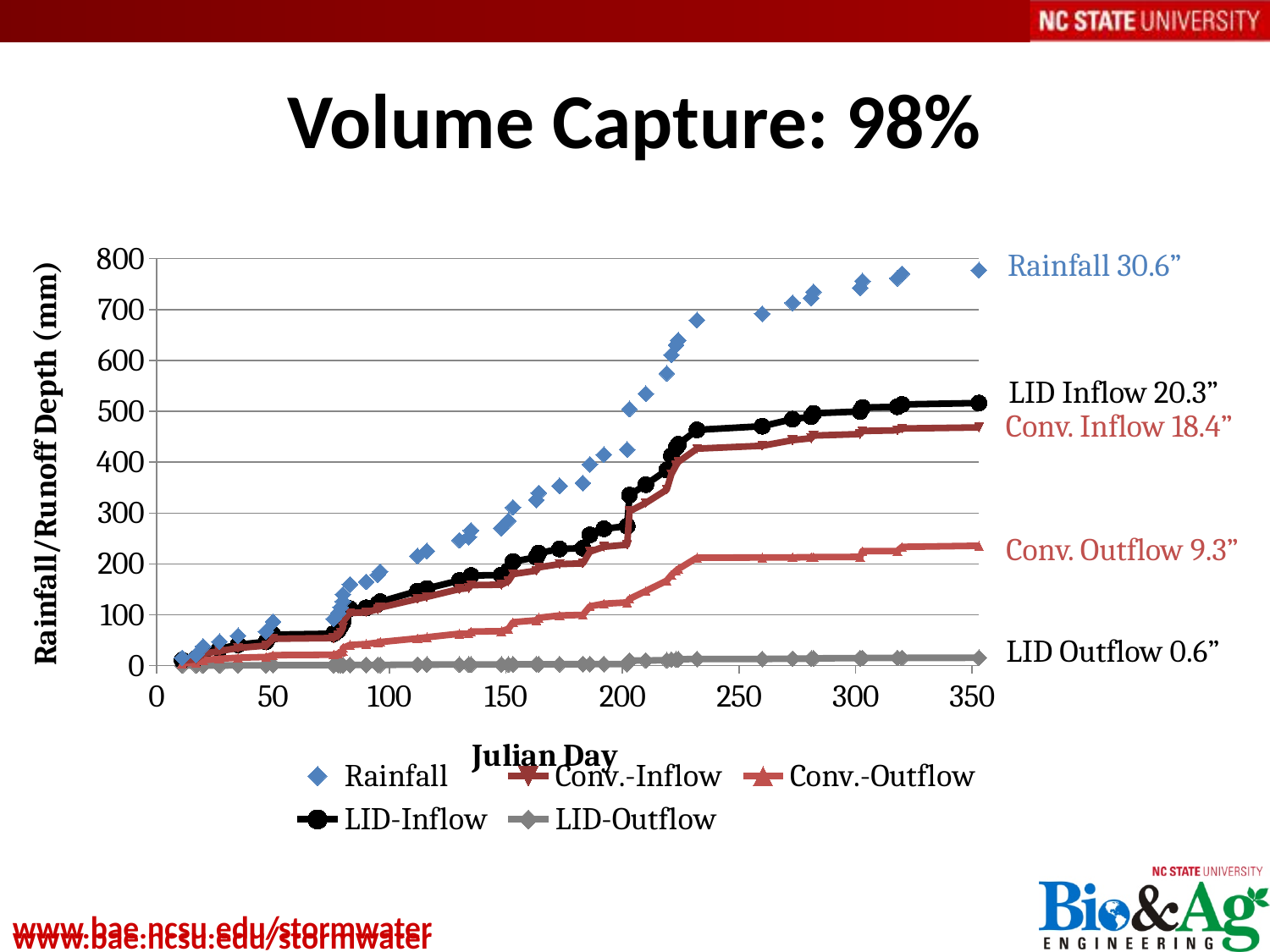
How many series does the legend list? 5 Is the value for Conv.-Outflow at Julian Day 350 greater or less than 300? less What is the title of the chart's x axis? Julian Day At the end of the x axis, which is larger: LID-Inflow or Conv.-Inflow? LID-Inflow What total depth is annotated for Rainfall on the right side of the chart? 30.6" Do the values of the Rainfall series rise or fall along the x axis? rise Which series has the lowest values across the chart? LID-Outflow Is the value for Rainfall at Julian Day 350 greater or less than 700? greater Which series reaches the highest value at the end of the x axis? Rainfall What is the title of the chart's y axis? Rainfall/Runoff Depth (mm) What kind of chart is shown on the slide? line chart Is the value for LID-Inflow at Julian Day 350 greater or less than 500? greater